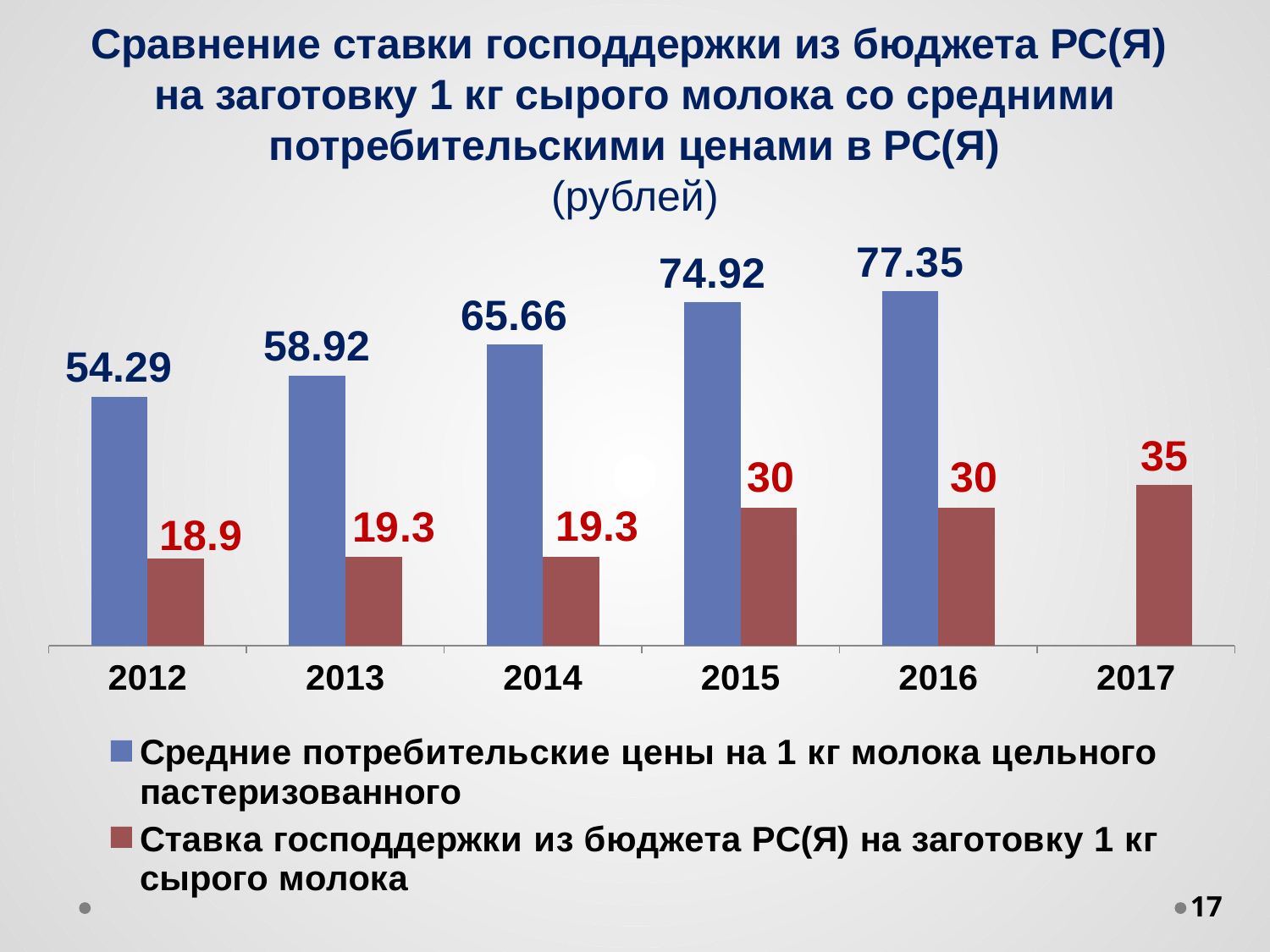
How many series does the legend list? 2 What is the state support rate in 2012? 18.9 Which colour represents the state support rate from the RS(Ya) budget? Red What is the state support rate from the RS(Ya) budget for procurement of 1 kg of raw milk in 2017? 35 Does the average consumer price rise or fall from 2012 to 2016? Rise What is the average consumer price for 1 kg of whole pasteurized milk in 2014? 65.66 Which is larger in 2015: the average consumer price or the state support rate? Average consumer price How many years are shown on the x axis? 6 In which year is the state support rate the lowest? 2012 What kind of chart is shown on the slide? Bar chart What is the difference between the average consumer price and the state support rate in 2016? 47.35 In which year is the average consumer price for 1 kg of milk the highest? 2016